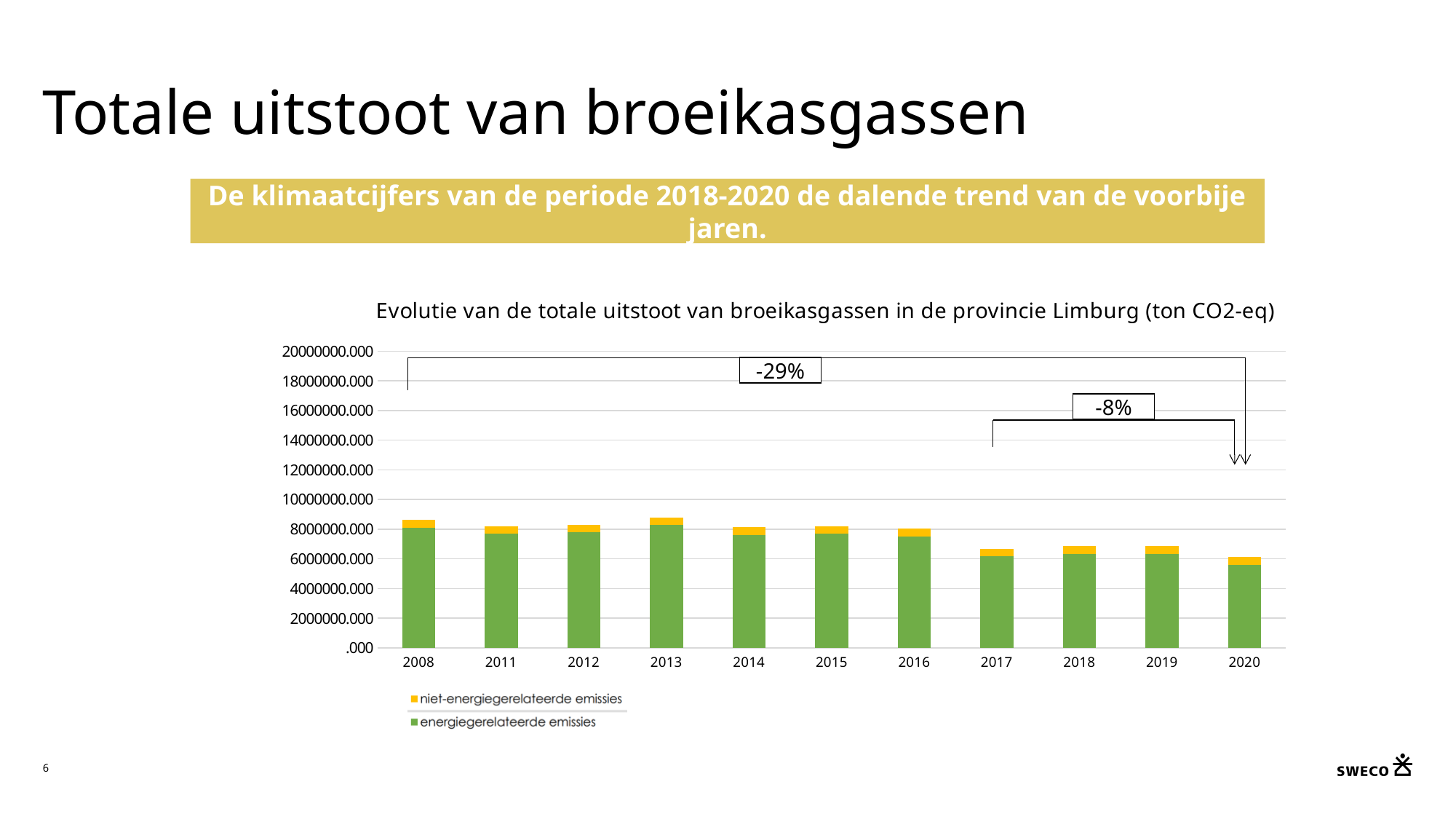
What percentage change is annotated on the chart between 2008 and 2020? -29% What kind of chart is shown on the slide? stacked bar chart Is the total emissions value for 2013 greater or less than 8000000.000? greater Do total emissions generally rise or fall from 2008 to 2020? fall How many series does the legend list? 2 Is the total emissions value for 2008 greater or less than 8000000.000? greater Which year has the lowest total emissions in the chart? 2020 Is the total emissions value for 2017 greater or less than 8000000.000? less What percentage change is annotated on the chart between 2017 and 2020? -8% Which year has higher total emissions, 2008 or 2020? 2008 How many years are shown on the x axis of the chart? 11